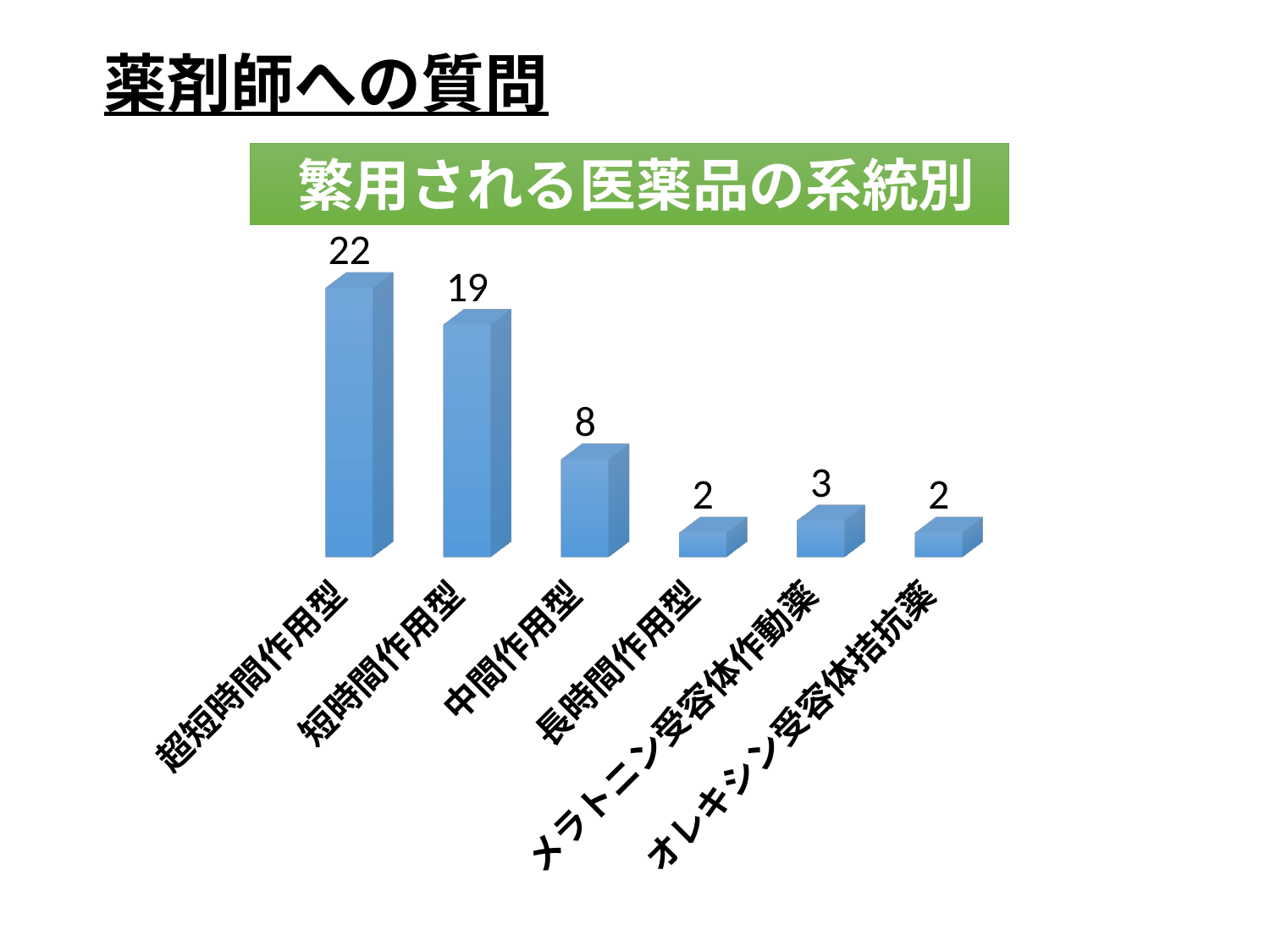
What is the title of the chart? 繁用される医薬品の系統別 What kind of chart is shown on the slide? bar chart Which is larger, the value for 中間作用型 or the value for メラトニン受容体作動薬? 中間作用型 Which categories share the lowest value of 2? 長時間作用型 and オレキシン受容体拮抗薬 What is the value for 超短時間作用型? 22 What is the value for メラトニン受容体作動薬? 3 Which category has the highest value? 超短時間作用型 What is the value for 短時間作用型? 19 How many categories are shown in the chart? 6 What is the difference between the values for 超短時間作用型 and 短時間作用型? 3 What is the value for 中間作用型? 8 What is the difference between the values for 短時間作用型 and 中間作用型? 11